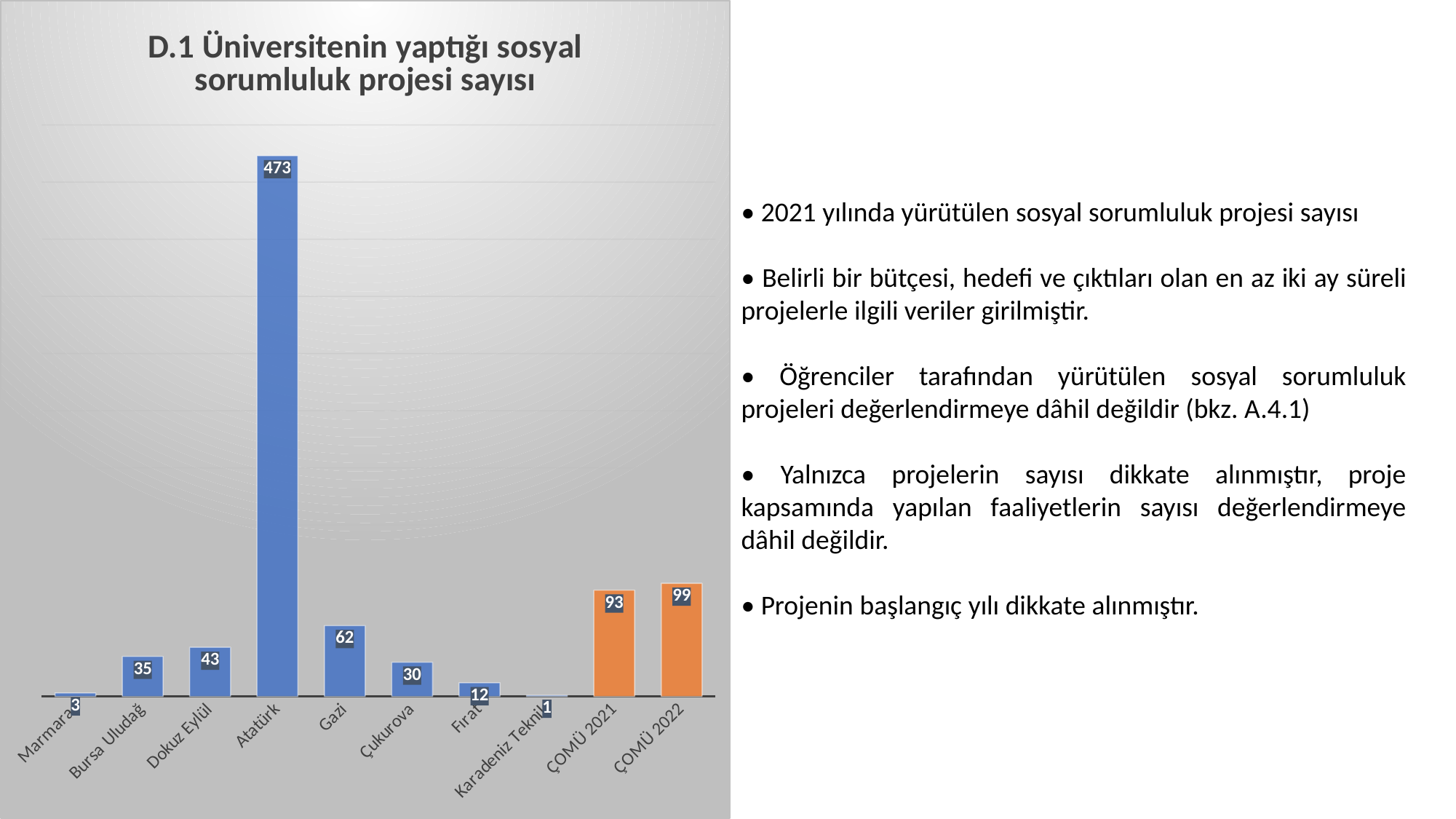
What is the value for Gazi? 62 Which is larger, the value for Bursa Uludağ or the value for Dokuz Eylül? Dokuz Eylül Which category has the lowest value? Karadeniz Teknik What is the value for Atatürk? 473 What is the difference between the values for Gazi and Çukurova? 32 What is the value for ÇOMÜ 2022? 99 How many categories are shown on the x axis? 10 Which category has the highest value? Atatürk What is the title of the chart? D.1 Üniversitenin yaptığı sosyal sorumluluk projesi sayısı What is the value for Karadeniz Teknik? 1 What kind of chart is this? Bar chart What is the difference between the values for ÇOMÜ 2022 and ÇOMÜ 2021? 6